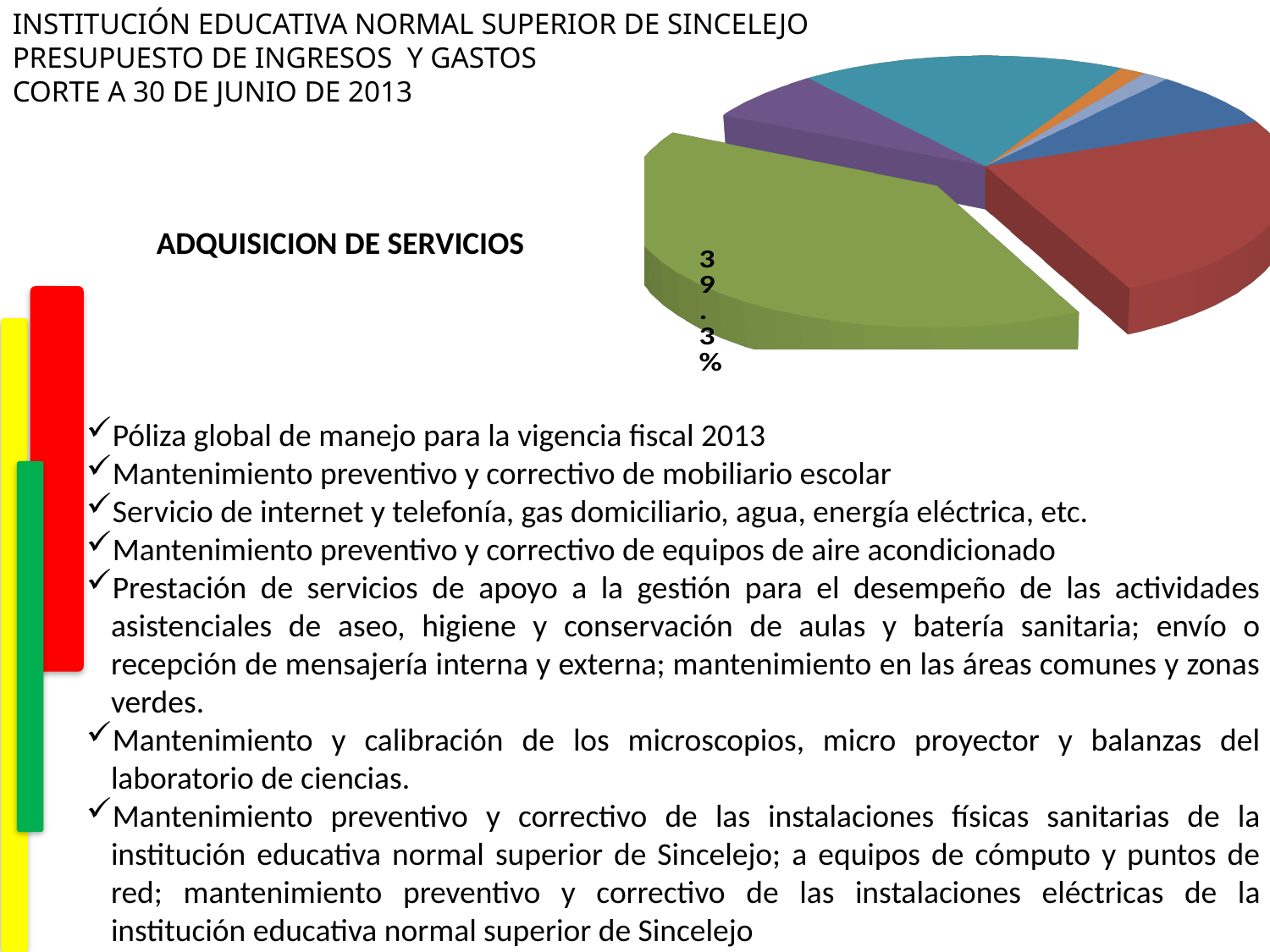
What kind of chart is shown on the slide? pie chart What is the share of the exploded green slice of the pie chart? 39.3% Is the share of the green slice of the pie chart greater or less than 50%? less Which colour is the slice that is pulled out (exploded) from the pie chart? green What percentage is printed as a data label on the pie chart? 39.3% Does the pie chart on the slide display a legend? No